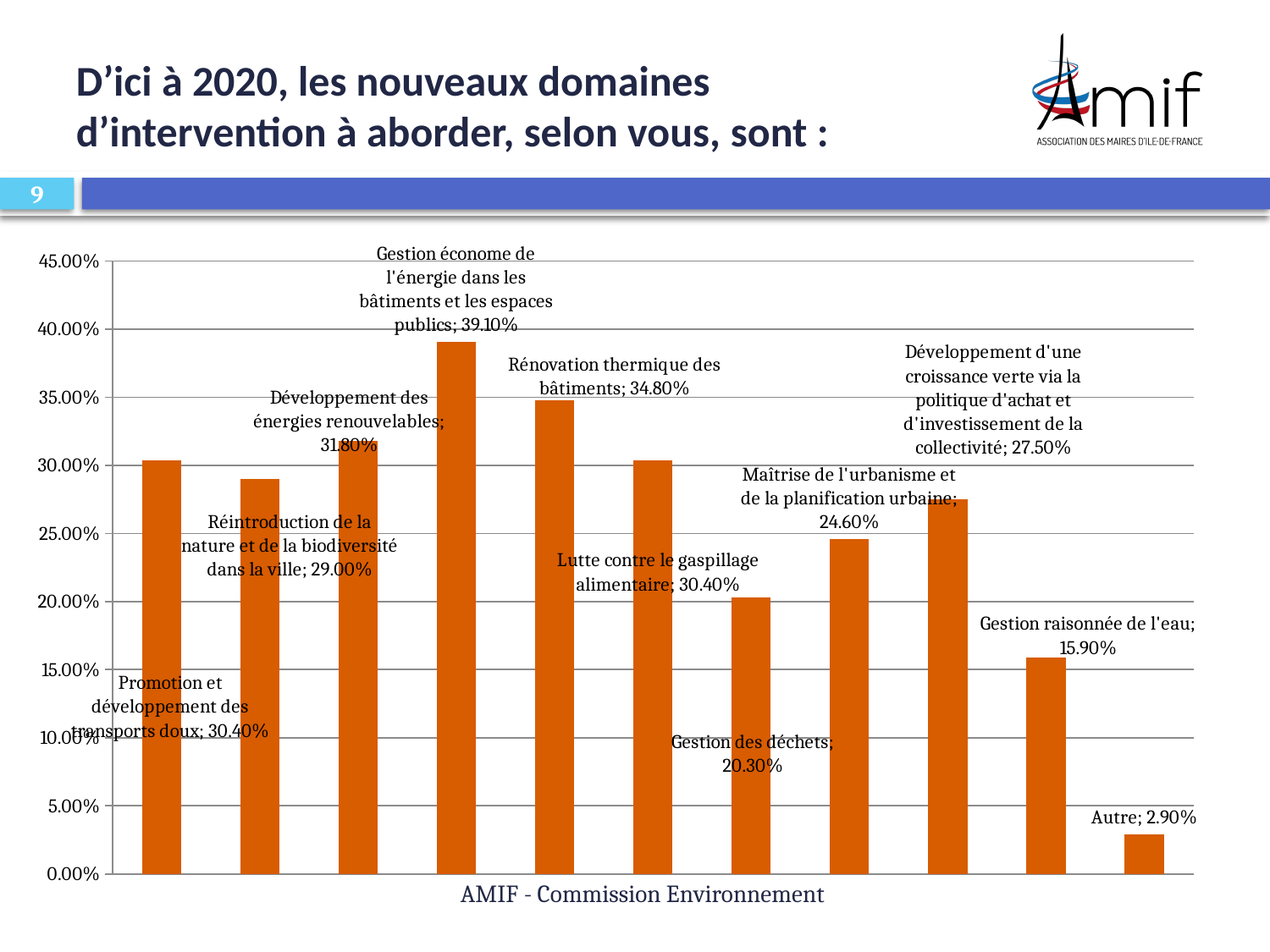
What is the value for "Gestion des déchets"? 20.30% What text appears as the axis title below the bars? AMIF - Commission Environnement Is the value for "Lutte contre le gaspillage alimentaire" greater or less than 25.00%? greater What is the value for "Gestion raisonnée de l'eau"? 15.90% Which category has the highest value? Gestion économe de l'énergie dans les bâtiments et les espaces publics How many bars (categories) does the chart show? 11 What is the value for "Rénovation thermique des bâtiments"? 34.80% Which category has the lowest value? Autre What is the value for "Gestion économe de l'énergie dans les bâtiments et les espaces publics"? 39.10% What is the difference between "Développement des énergies renouvelables" (31.80%) and "Réintroduction de la nature et de la biodiversité dans la ville" (29.00%)? 2.80% What kind of chart is shown on the slide? Bar chart Which is larger: "Maîtrise de l'urbanisme et de la planification urbaine" or "Développement d'une croissance verte via la politique d'achat et d'investissement de la collectivité"? Développement d'une croissance verte via la politique d'achat et d'investissement de la collectivité